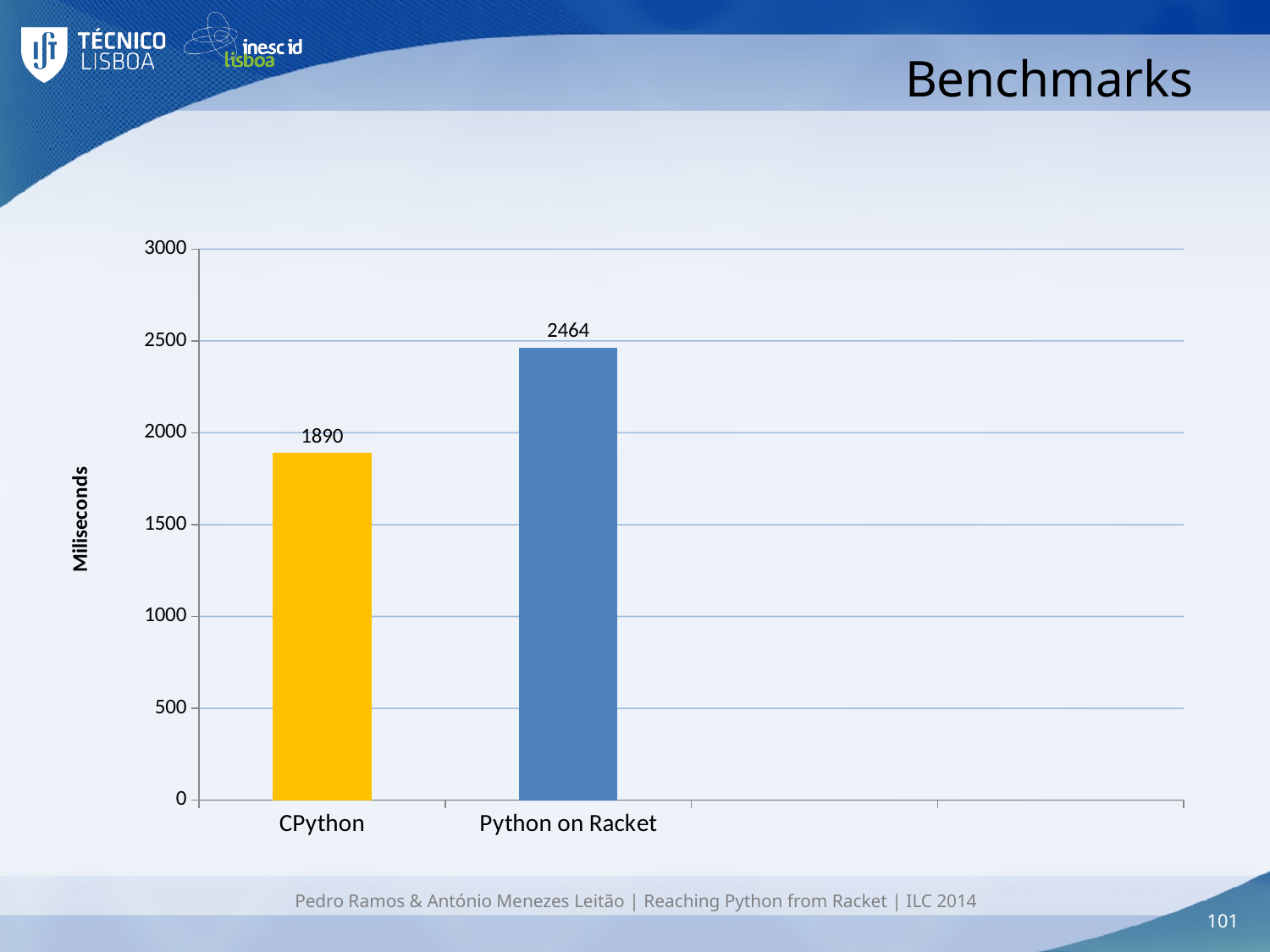
What is the label of the vertical axis? Miliseconds How many categories are shown in the chart? 2 What kind of chart is shown on the slide? bar chart What colour is the bar for CPython? yellow Which is larger, the value for CPython or the value for Python on Racket? Python on Racket Is the value for CPython greater or less than 2000? less What is the value for CPython? 1890 Which category has the lowest value? CPython Is the value for Python on Racket greater or less than 2000? greater Which category has the highest value? Python on Racket What is the value for Python on Racket? 2464 What is the difference between the values for Python on Racket and CPython? 574